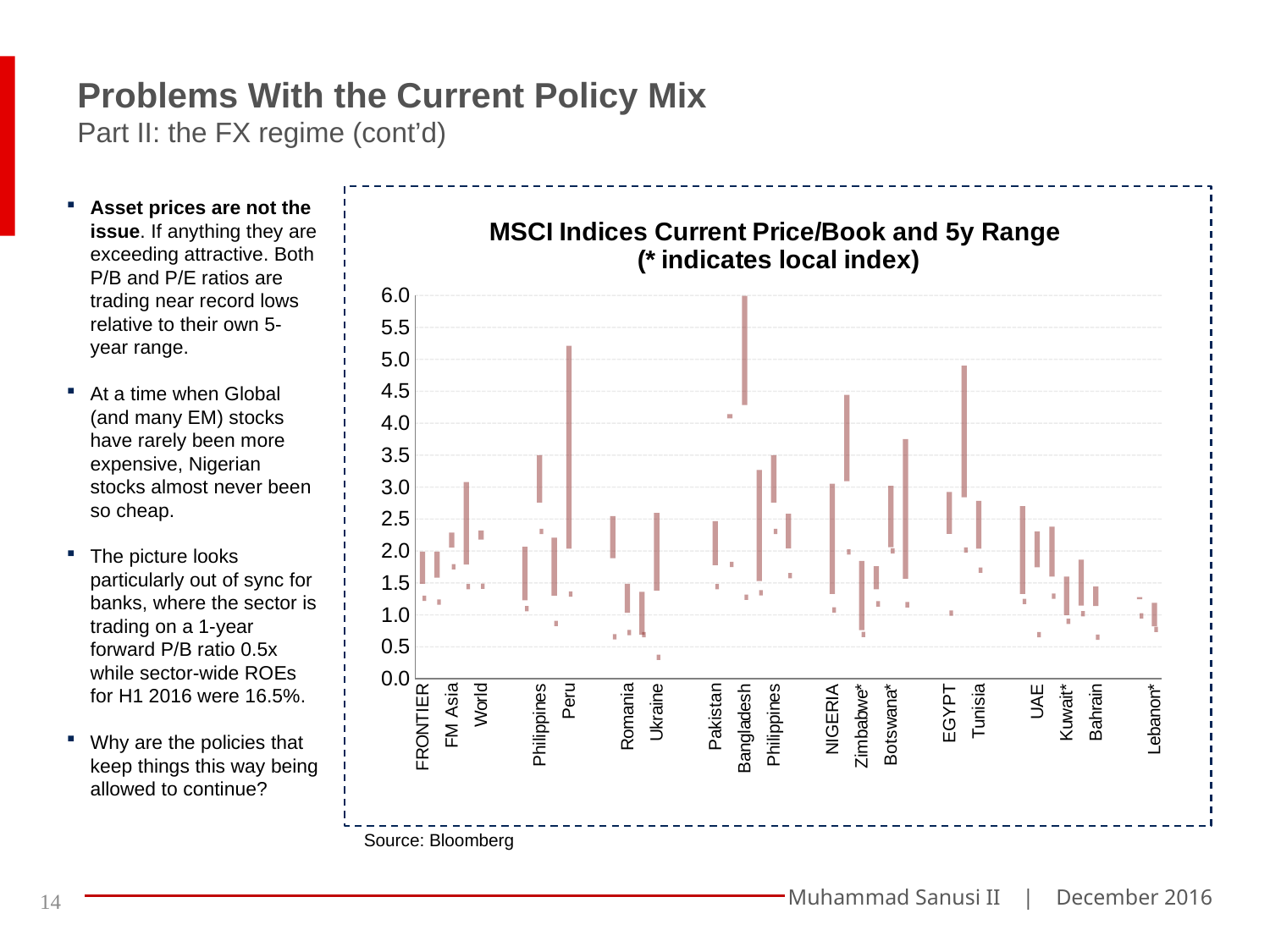
Which range reaches higher, Bangladesh or Peru? Bangladesh Is the top of the Bangladesh range greater or less than 5.5? greater Is the current price/book value (the dot) for NIGERIA greater or less than 1.5? less Is the top of the EGYPT range greater or less than 2.5? greater What is the title of the chart? MSCI Indices Current Price/Book and 5y Range (* indicates local index) According to the chart title, what does an asterisk (*) after a category name indicate? local index Which category's 5-year range reaches the highest value on the chart? Bangladesh What kind of chart is shown on the slide? bar chart